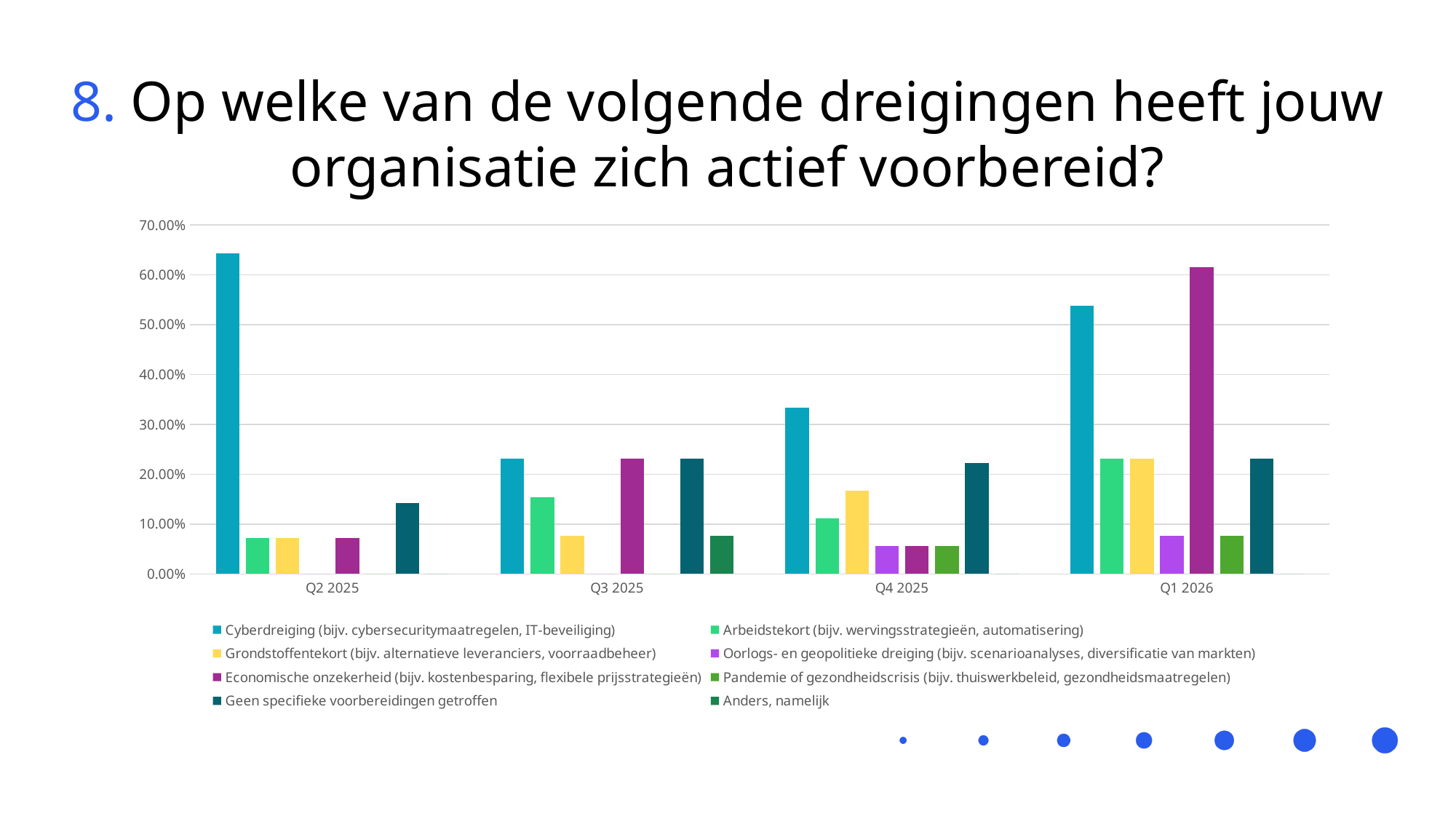
Which series has the highest bar in Q2 2025? Cyberdreiging (bijv. cybersecuritymaatregelen, IT-beveiliging) Is the value for Economische onzekerheid in Q1 2026 greater or less than 50.00%? greater Is the value for Geen specifieke voorbereidingen getroffen in Q2 2025 greater or less than 20.00%? less How many quarters are shown on the x axis of the chart? 4 In which quarter is the Cyberdreiging bar the highest? Q2 2025 Which is larger: the Cyberdreiging value in Q2 2025 or in Q4 2025? Q2 2025 Is the value for Cyberdreiging in Q2 2025 greater or less than 60.00%? greater How many series does the chart's legend list? 8 Which series has the highest bar in Q1 2026? Economische onzekerheid (bijv. kostenbesparing, flexibele prijsstrategieën) Does the Cyberdreiging value rise or fall from Q2 2025 to Q3 2025? fall What kind of chart is shown on the slide? Bar chart